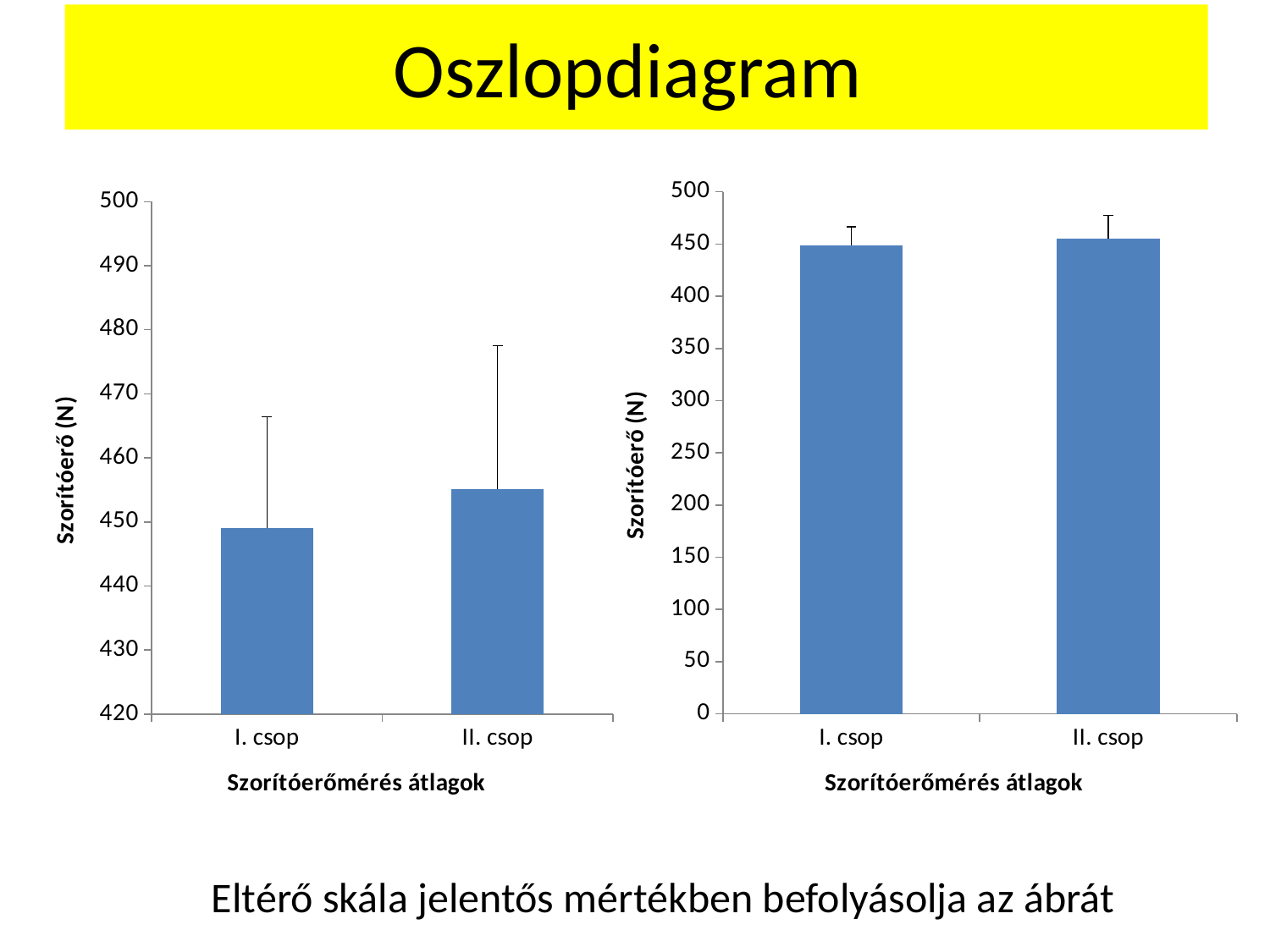
In the left chart, which is larger, the value for I. csop or the value for II. csop? II. csop What kind of chart is the left chart on the slide? bar chart In the left chart, is the value for II. csop greater or less than 450? greater In the left chart, which category has the highest value? II. csop How many categories are shown on the x axis of the right chart? 2 In the right chart, is the value for I. csop greater or less than 400? greater In the left chart, is the value for I. csop greater or less than 440? greater How many categories are shown on the x axis of the left chart? 2 What is the y-axis title of the right chart? Szorítóerő (N) In the left chart, which category has the lowest value? I. csop At what value does the y axis of the left chart start? 420